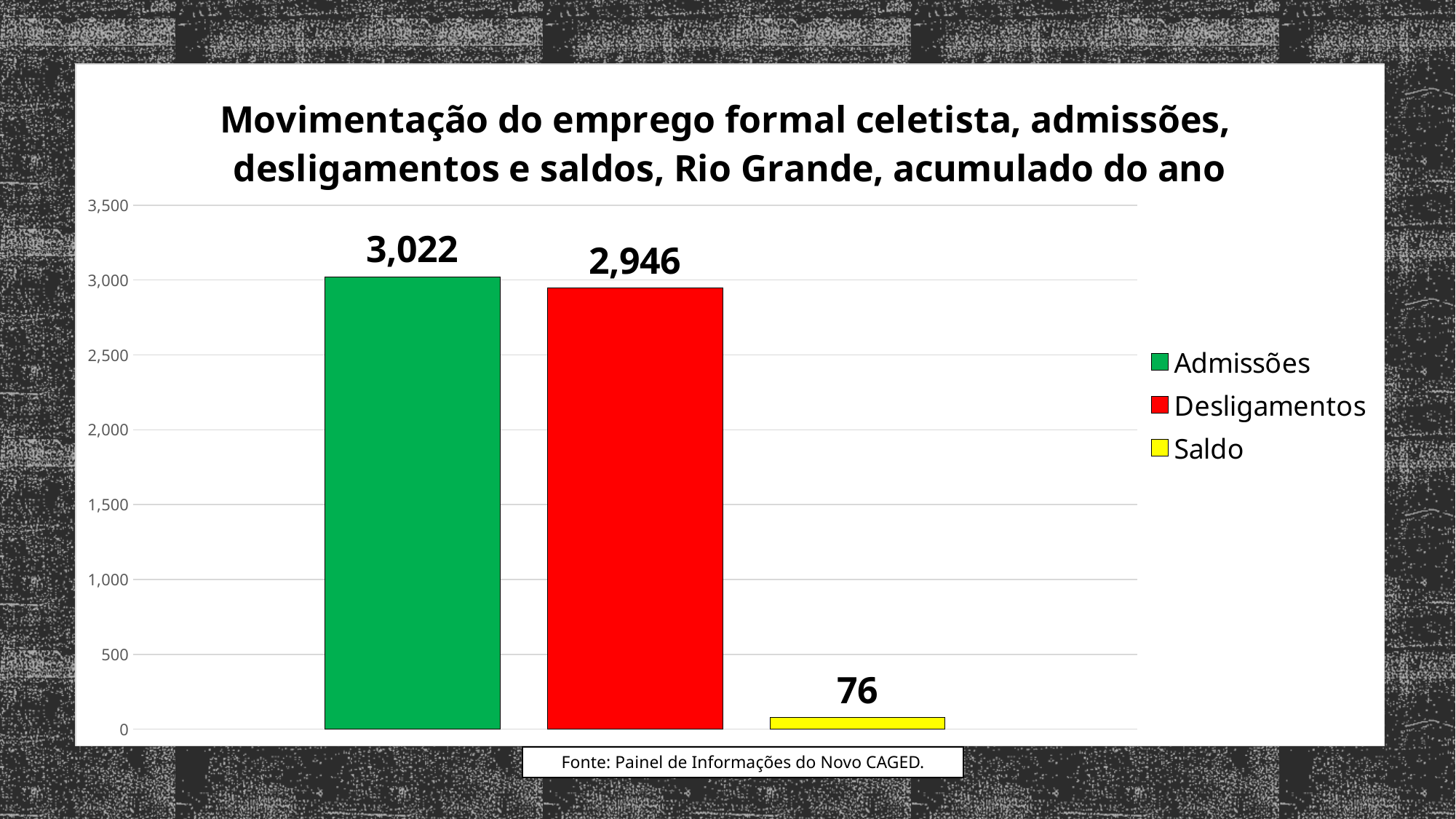
What kind of chart is shown? bar chart What is the value for Desligamentos? 2,946 Is the value for Desligamentos greater or less than 3,000? less What is the difference between Admissões and Desligamentos? 76 Which series has the lowest value? Saldo What colour is the bar for Saldo? yellow What is the value for Saldo? 76 What is the value for Admissões? 3,022 Which is larger, Admissões or Desligamentos? Admissões How many series does the legend list? 3 Which series has the highest value? Admissões Is the value for Admissões greater or less than 3,000? greater